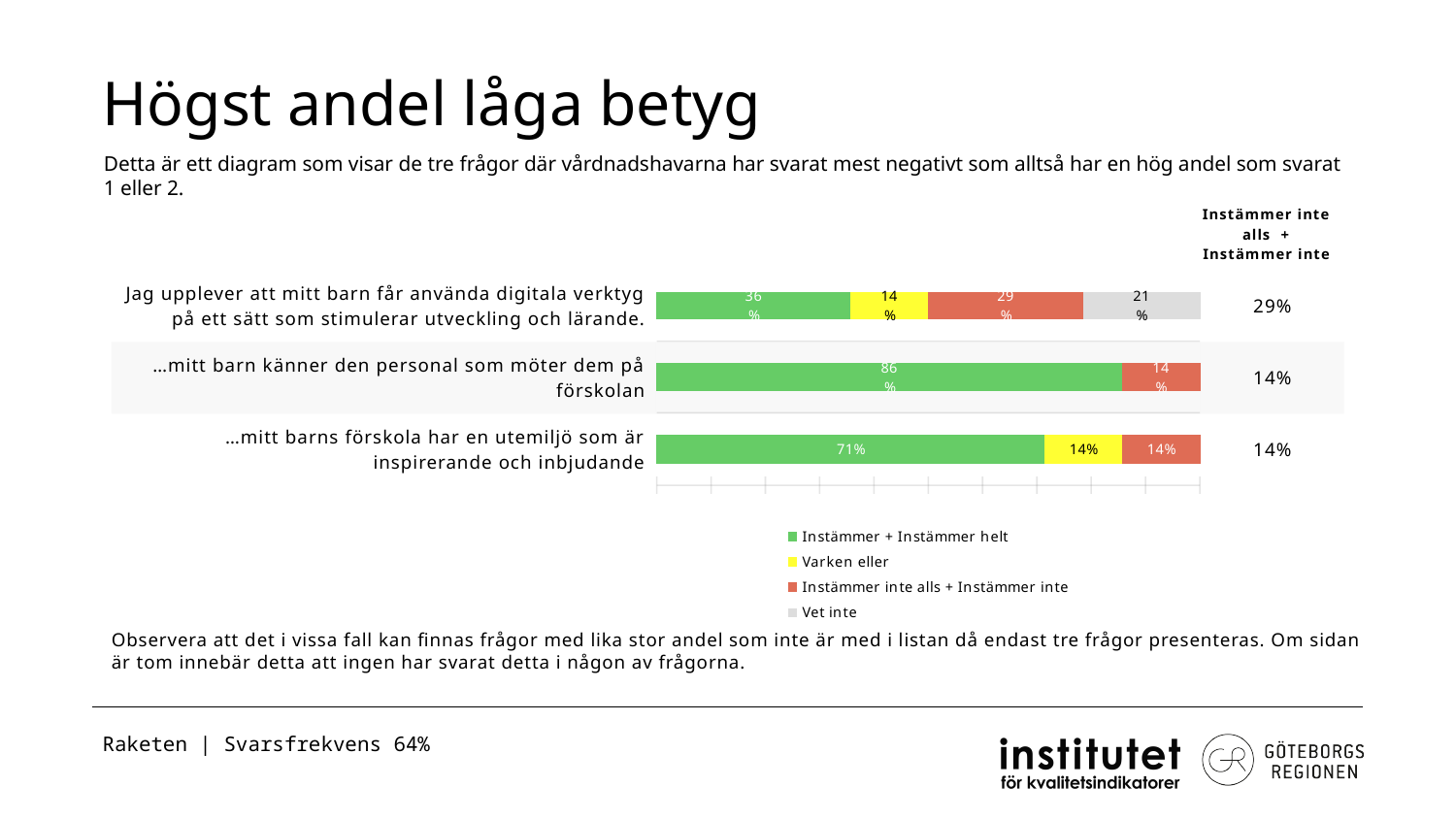
What is the value of "Instämmer inte alls + Instämmer inte" for "Jag upplever att mitt barn får använda digitala verktyg på ett sätt som stimulerar utveckling och lärande"? 29% Which question has the lowest share of "Instämmer + Instämmer helt"? Jag upplever att mitt barn får använda digitala verktyg på ett sätt som stimulerar utveckling och lärande What is the value of "Instämmer + Instämmer helt" for "…mitt barns förskola har en utemiljö som är inspirerande och inbjudande"? 71% What kind of chart is shown on the slide? Stacked bar chart How many questions (categories) are plotted in the chart? 3 Which is larger: the "Instämmer inte alls + Instämmer inte" share for the digital tools question or for the outdoor environment question? The digital tools question What is the difference between the "Instämmer + Instämmer helt" values for "…mitt barn känner den personal som möter dem på förskolan" and "…mitt barns förskola har en utemiljö som är inspirerande och inbjudande"? 15% How many series does the legend list? 4 What is the value of "Instämmer + Instämmer helt" for "…mitt barn känner den personal som möter dem på förskolan"? 86% Which question has the highest share of "Instämmer + Instämmer helt"? …mitt barn känner den personal som möter dem på förskolan What is the value of "Vet inte" for "Jag upplever att mitt barn får använda digitala verktyg på ett sätt som stimulerar utveckling och lärande"? 21% What colour represents "Varken eller" in the legend? Yellow